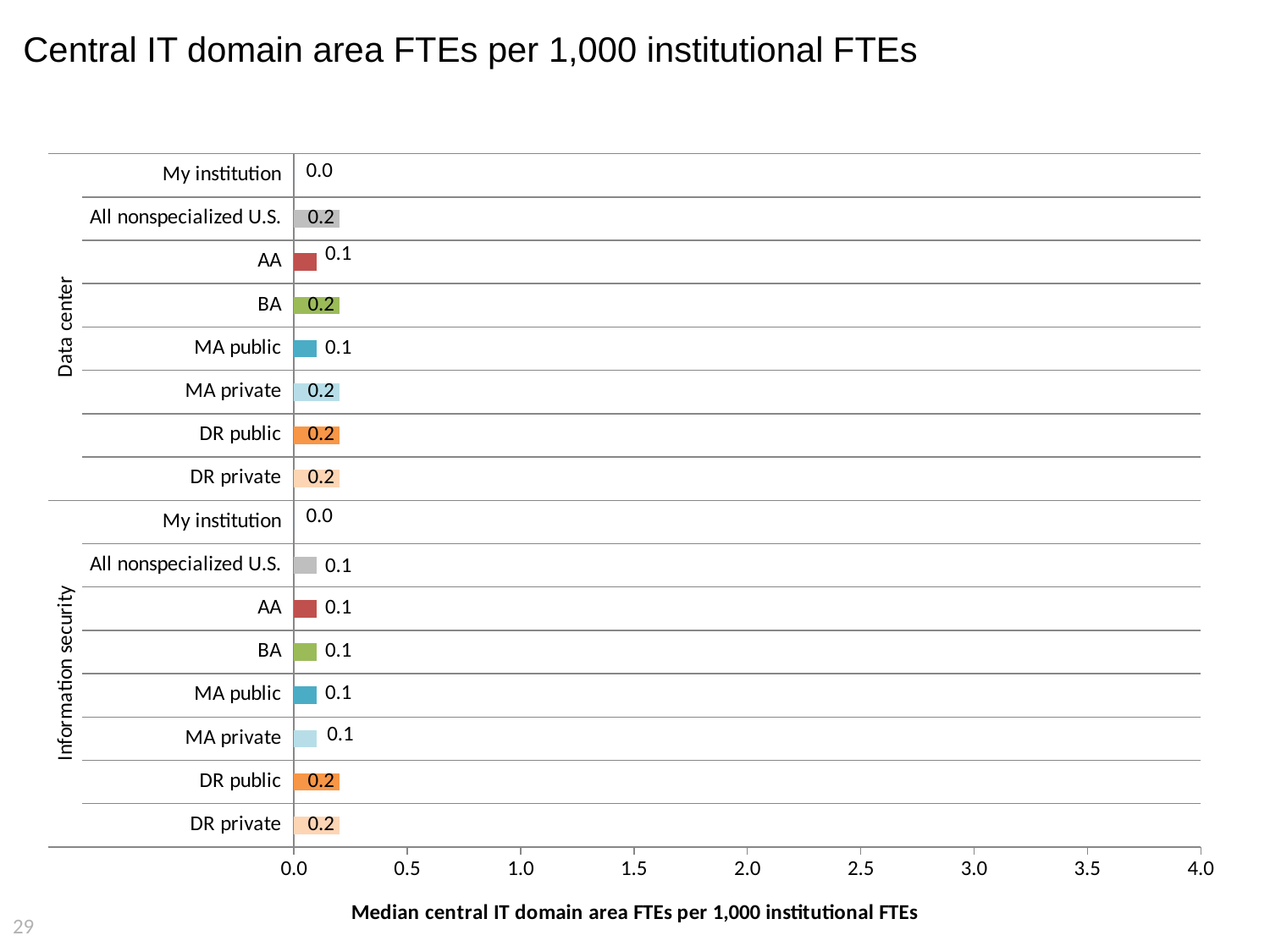
Which category has the lowest value in the Data center group? My institution What is the Information security value for DR public? 0.2 How many categories are shown in the Information security group? 8 In the Data center group, what is the difference between the value for All nonspecialized U.S. and the value for AA? 0.1 What kind of chart is shown on the slide? bar chart In the Data center group, which is larger, the value for BA or the value for AA? BA What is the x-axis title of the chart? Median central IT domain area FTEs per 1,000 institutional FTEs What is the maximum value shown on the x axis? 4.0 What is the Data center value for All nonspecialized U.S.? 0.2 Is the Information security value for DR private greater or less than 0.5? less What is the Information security value for All nonspecialized U.S.? 0.1 What is the Data center value for MA public? 0.1